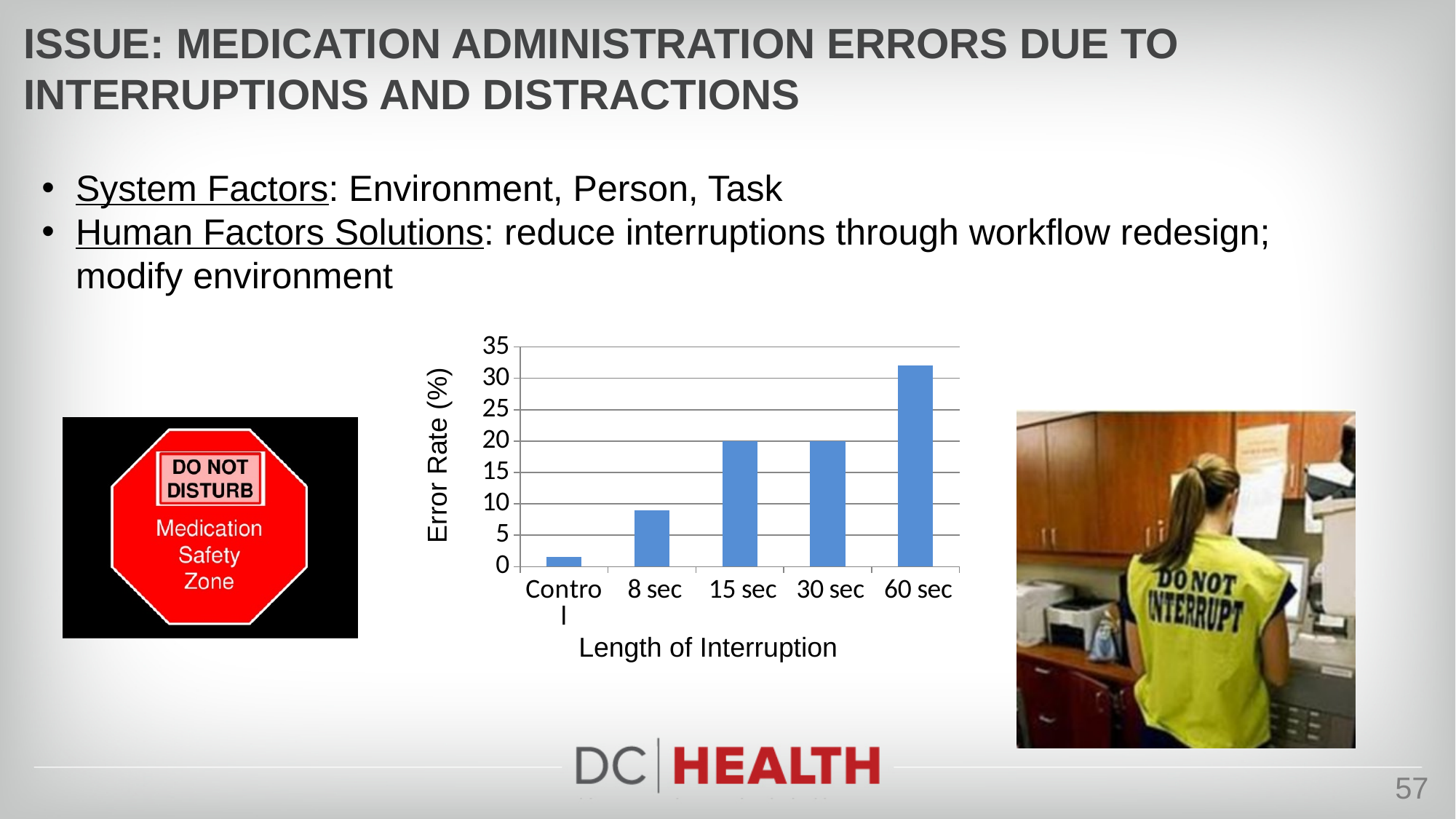
Is the error rate for 60 sec greater or less than 30? greater What kind of chart is shown on the slide? bar chart What is the label of the y axis of the chart? Error Rate (%) Is the error rate for 8 sec greater or less than 10? less What is the error rate for 15 sec? 20 Is the error rate for Control greater or less than 5? less Which length of interruption has the highest error rate? 60 sec Which category has the lowest error rate? Control How many categories are shown on the x axis of the chart? 5 What is the error rate for 30 sec? 20 Which has a higher error rate, 8 sec or 60 sec? 60 sec Do error rates generally rise or fall as the length of interruption increases along the x axis? rise